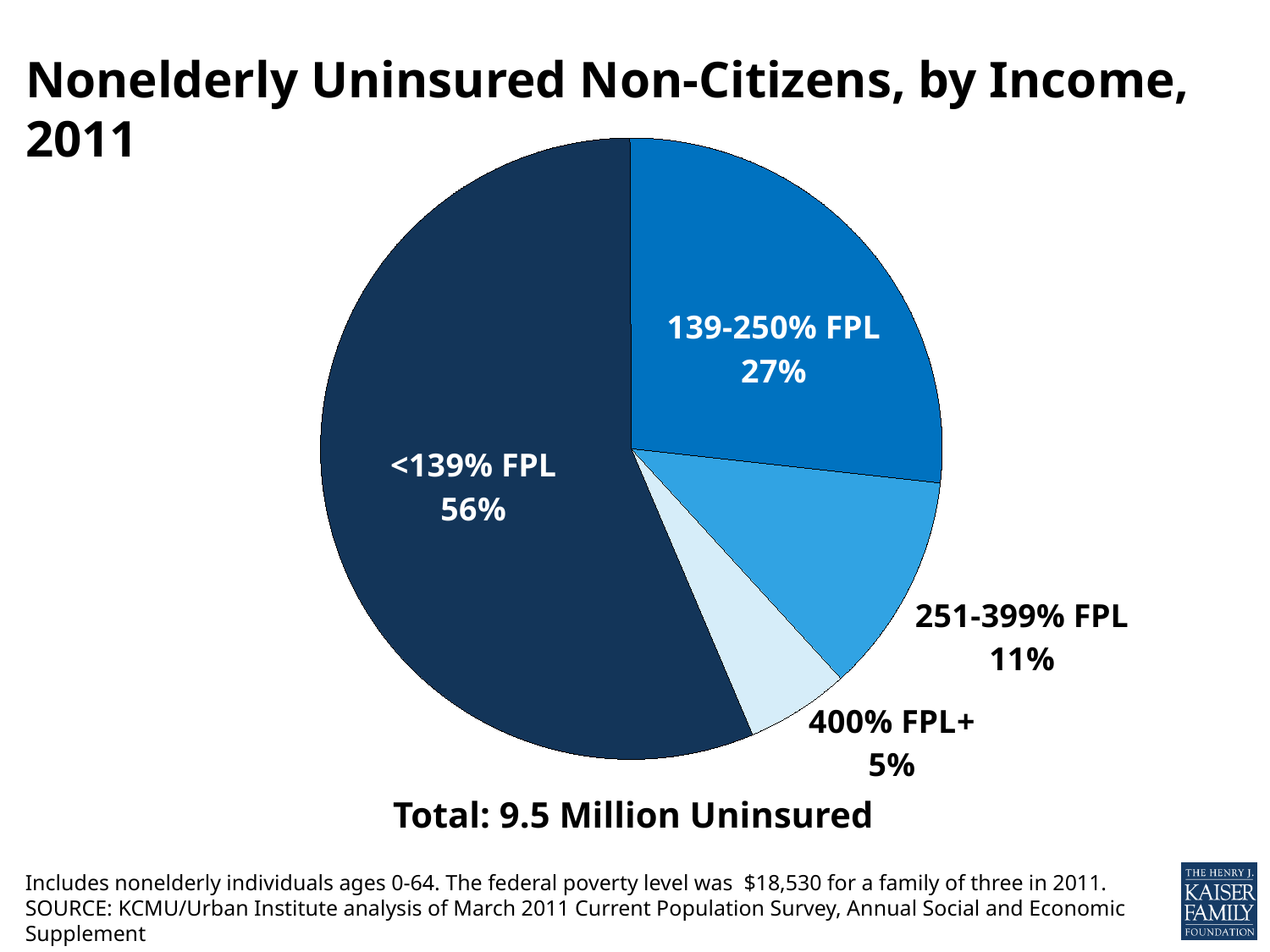
What share is shown for 400% FPL+? 5% What percentage of the pie is the 139-250% FPL slice? 27% What type of chart is shown on the slide? Pie chart How many percentage points larger is the <139% FPL slice than the 139-250% FPL slice? 29 Which income category has the smallest share of the pie? 400% FPL+ Which is larger, the share for 139-250% FPL or the share for 251-399% FPL? 139-250% FPL What share of nonelderly uninsured non-citizens had incomes below 139% FPL? 56% Which income category has the largest share of the pie? <139% FPL What is the difference in percentage points between the 251-399% FPL and 400% FPL+ slices? 6 What is the value shown for the 251-399% FPL category? 11% What total number of uninsured does the chart represent, according to the label below the pie? 9.5 Million Uninsured How many income categories are shown in the pie chart? 4